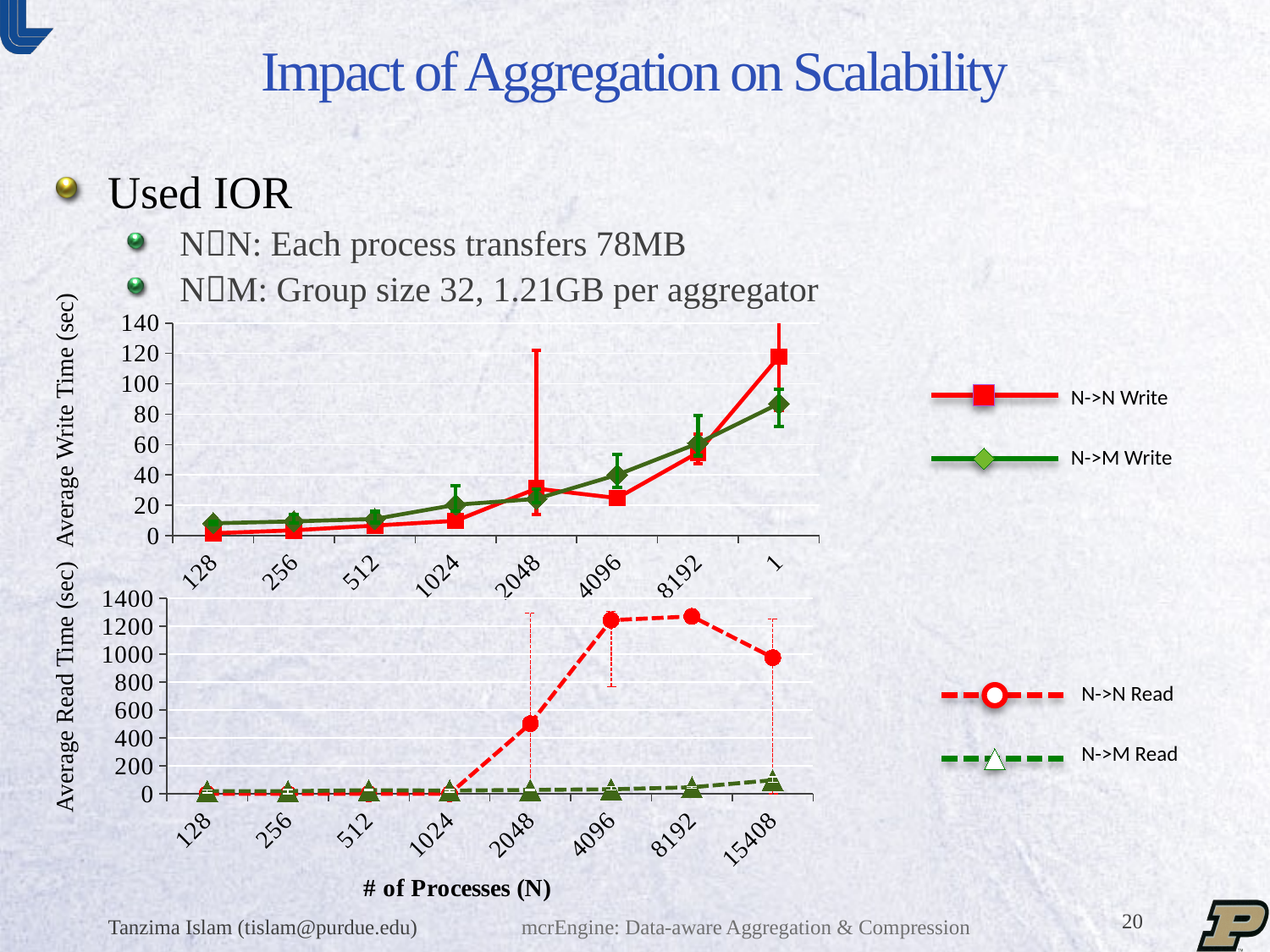
How many series does the legend of the top chart (Average Write Time) list? 2 In the bottom chart (Average Read Time), which series has the larger value at 8192 processes, N->N Read or N->M Read? N->N Read In the top chart (Average Write Time), which series has the larger value at 4096 processes, N->N Write or N->M Write? N->M Write In the bottom chart (Average Read Time), is the N->N Read value at 4096 processes greater or less than 1000? greater What kind of chart is the top chart (Average Write Time)? line chart In the top chart (Average Write Time), does the N->M Write series rise or fall as the number of processes increases? rises How many process counts are shown on the x axis of the bottom chart (Average Read Time)? 8 In the top chart (Average Write Time), is the N->M Write value at 4096 processes greater or less than 20? greater In the top chart (Average Write Time), is the N->N Write value at 4096 processes greater or less than 40? less How many series does the legend of the bottom chart (Average Read Time) list? 2 What is the x-axis title shown below the bottom chart? # of Processes (N)